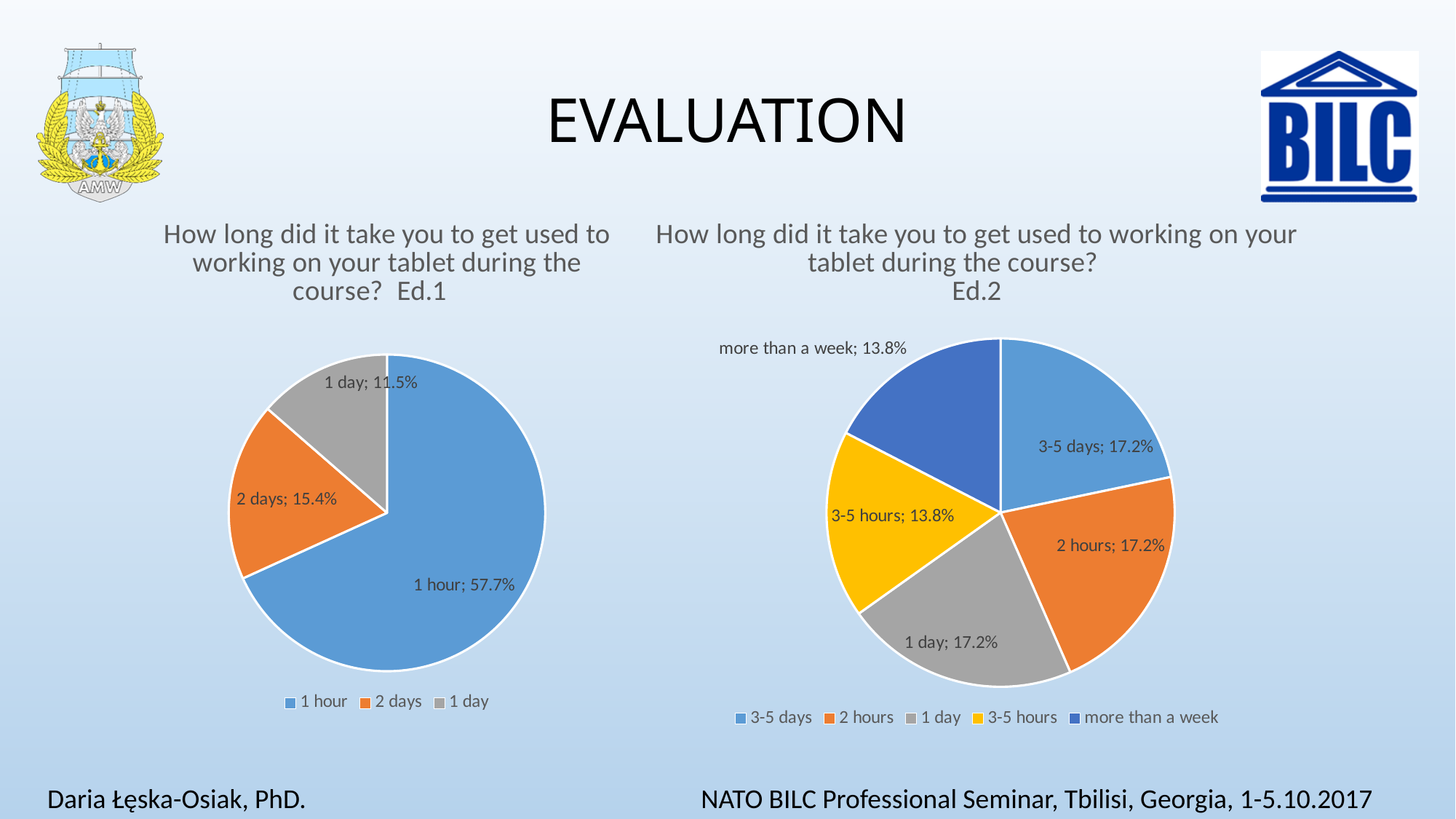
In the Ed.2 pie chart on the right, how many slices does the pie have? 5 In the Ed.1 pie chart on the left, how many categories does the legend list? 3 What type of chart is used on the right side of the slide for Ed.2? Pie chart In the Ed.1 pie chart on the left, which category has the largest share? 1 hour In the Ed.2 pie chart on the right, what share of respondents answered "1 day"? 17.2% In the Ed.1 pie chart on the left, which category has the smallest share? 1 day In the Ed.2 pie chart on the right, which is larger: the share for "2 hours" or the share for "3-5 hours"? 2 hours In the Ed.1 pie chart on the left, what is the difference between the shares for "1 hour" and "2 days"? 42.3 percentage points In the Ed.2 pie chart on the right, what colour is the "3-5 hours" slice? Yellow In the Ed.1 pie chart on the left, what share of respondents answered "1 hour"? 57.7% In the Ed.1 pie chart on the left, what share of respondents answered "2 days"? 15.4% In the Ed.2 pie chart on the right, what share of respondents answered "more than a week"? 13.8%